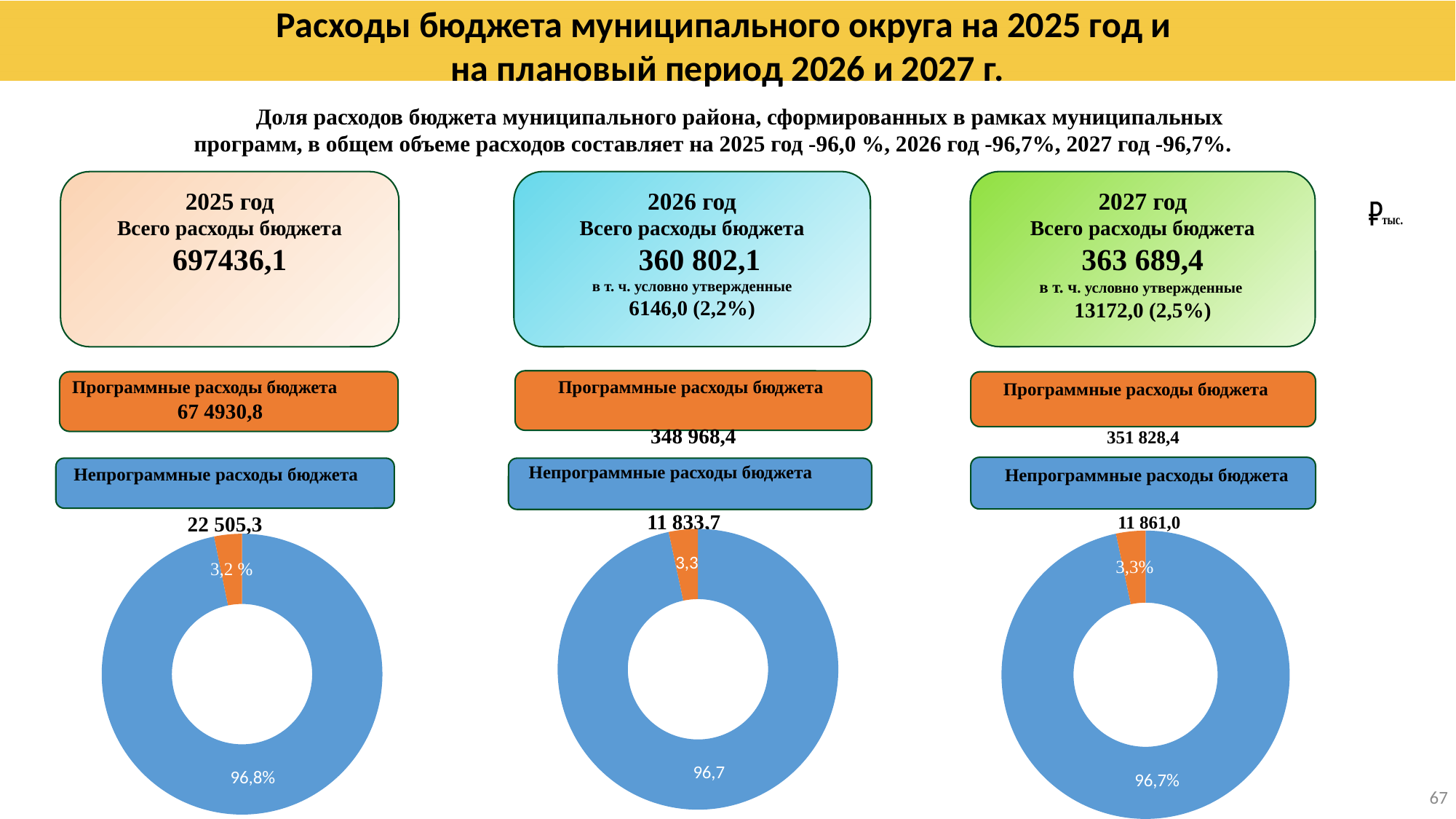
In the donut chart under the 2025 год column, which slice is the smallest? The orange slice (3,2 %) How many charts are shown on the slide? 3 In the donut chart under the 2025 год column, what percentage is printed on the orange slice? 3,2 % In the donut chart under the 2025 год column, what percentage is printed on the blue slice? 96,8% In the donut chart under the 2026 год column, what value is printed on the blue slice? 96,7 What colour is the large slice in each of the three donut charts? Blue How many slices does the donut chart under the 2025 год column have? 2 In the donut chart under the 2027 год column, what percentage is printed on the orange slice? 3,3% In the donut chart under the 2027 год column, which slice is larger, the blue one or the orange one? The blue one What kind of chart is shown under the 2025 год column? Donut (pie) chart In the donut chart under the 2027 год column, what percentage is printed on the blue slice? 96,7% In the donut chart under the 2026 год column, what value is printed on the orange slice? 3,3